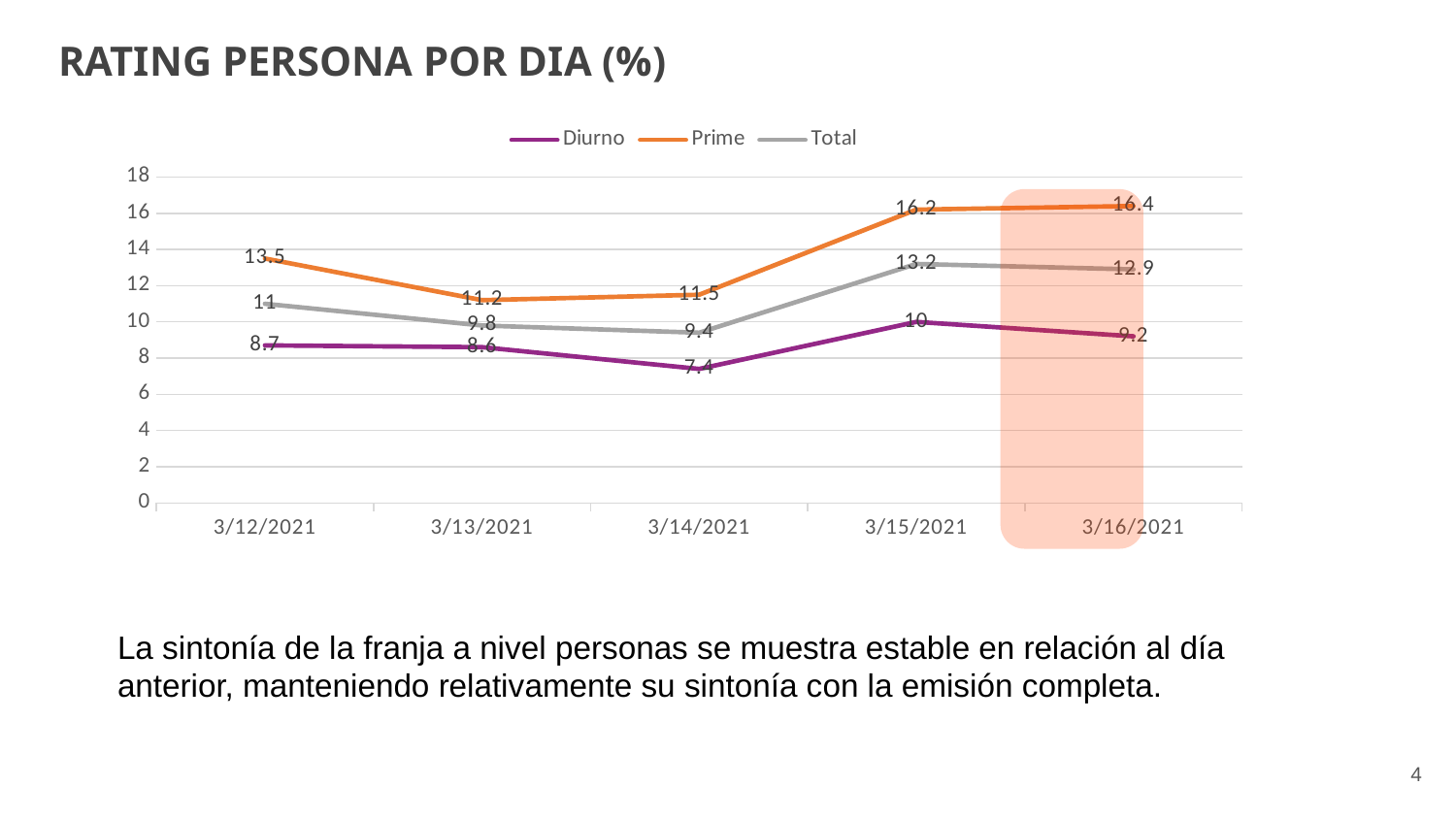
Does the Prime series rise or fall from 3/14/2021 to 3/15/2021? rise Which is larger on 3/12/2021, the Total value or the Diurno value? Total What is the Total value on 3/15/2021? 13.2 How many dates are plotted on the x axis? 5 What is the Prime value on 3/16/2021? 16.4 On which date is the Diurno value lowest? 3/14/2021 What is the difference between the Prime and Diurno values on 3/15/2021? 6.2 On which date is the Prime value highest? 3/16/2021 Which series is drawn in orange? Prime What type of chart is shown on the slide? line chart What is the Diurno value on 3/14/2021? 7.4 How many series does the legend list? 3